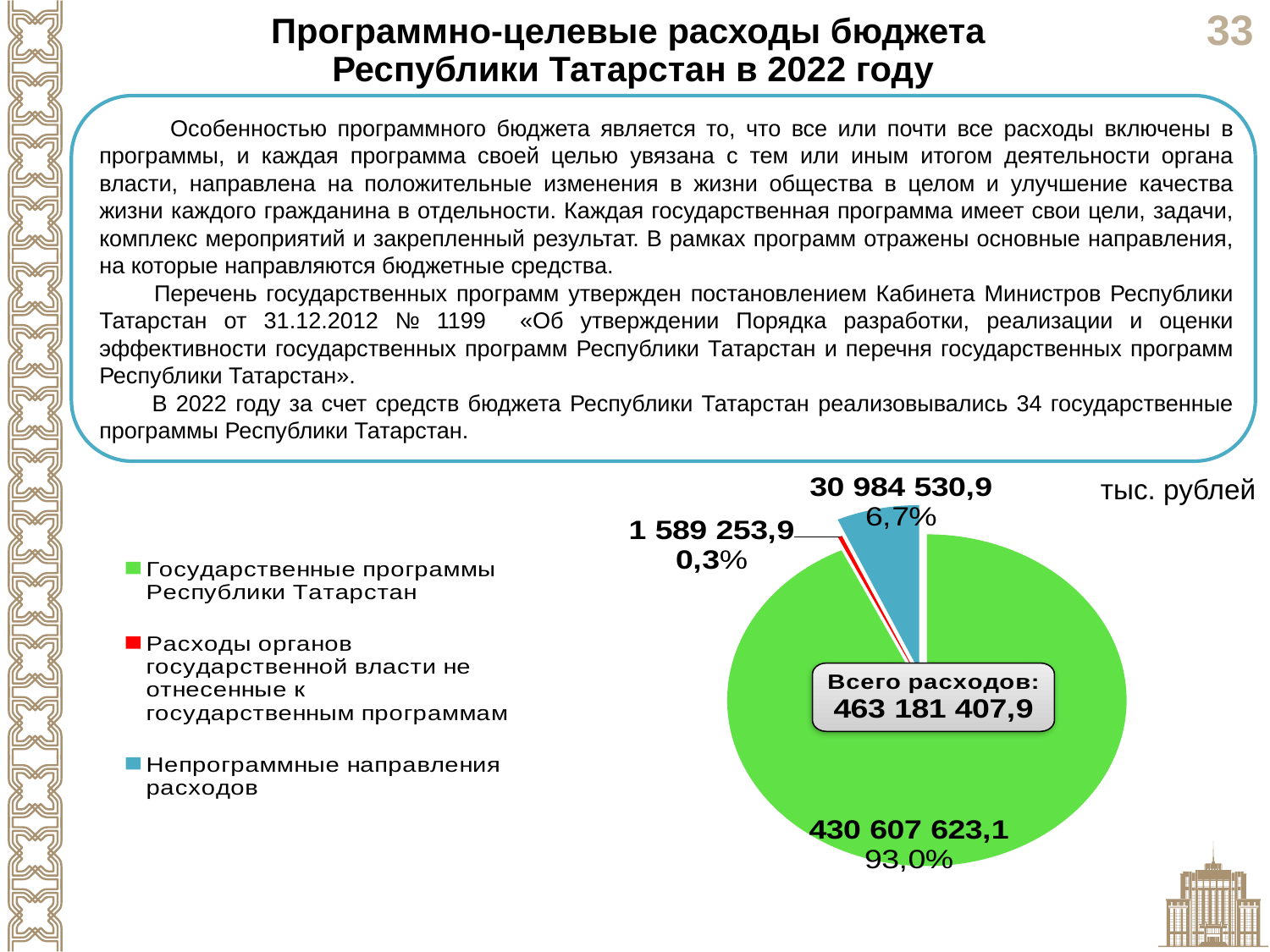
How many slices does the pie chart have? 3 What kind of chart is shown on the slide? pie chart Which category has the smallest slice in the pie chart? Расходы органов государственной власти не отнесенные к государственным программам What is the value for Расходы органов государственной власти не отнесенные к государственным программам in the pie chart? 1 589 253,9 What is the value for Государственные программы Республики Татарстан in the pie chart? 430 607 623,1 What is the value for Непрограммные направления расходов in the pie chart? 30 984 530,9 What total expenditure (Всего расходов) is shown in the centre of the pie chart? 463 181 407,9 How many entries does the legend of the pie chart list? 3 What share of the pie does Непрограммные направления расходов account for? 6,7% Which is larger in the pie chart: Непрограммные направления расходов or Расходы органов государственной власти не отнесенные к государственным программам? Непрограммные направления расходов What share of the pie does Государственные программы Республики Татарстан account for? 93,0% Which category has the largest slice in the pie chart? Государственные программы Республики Татарстан